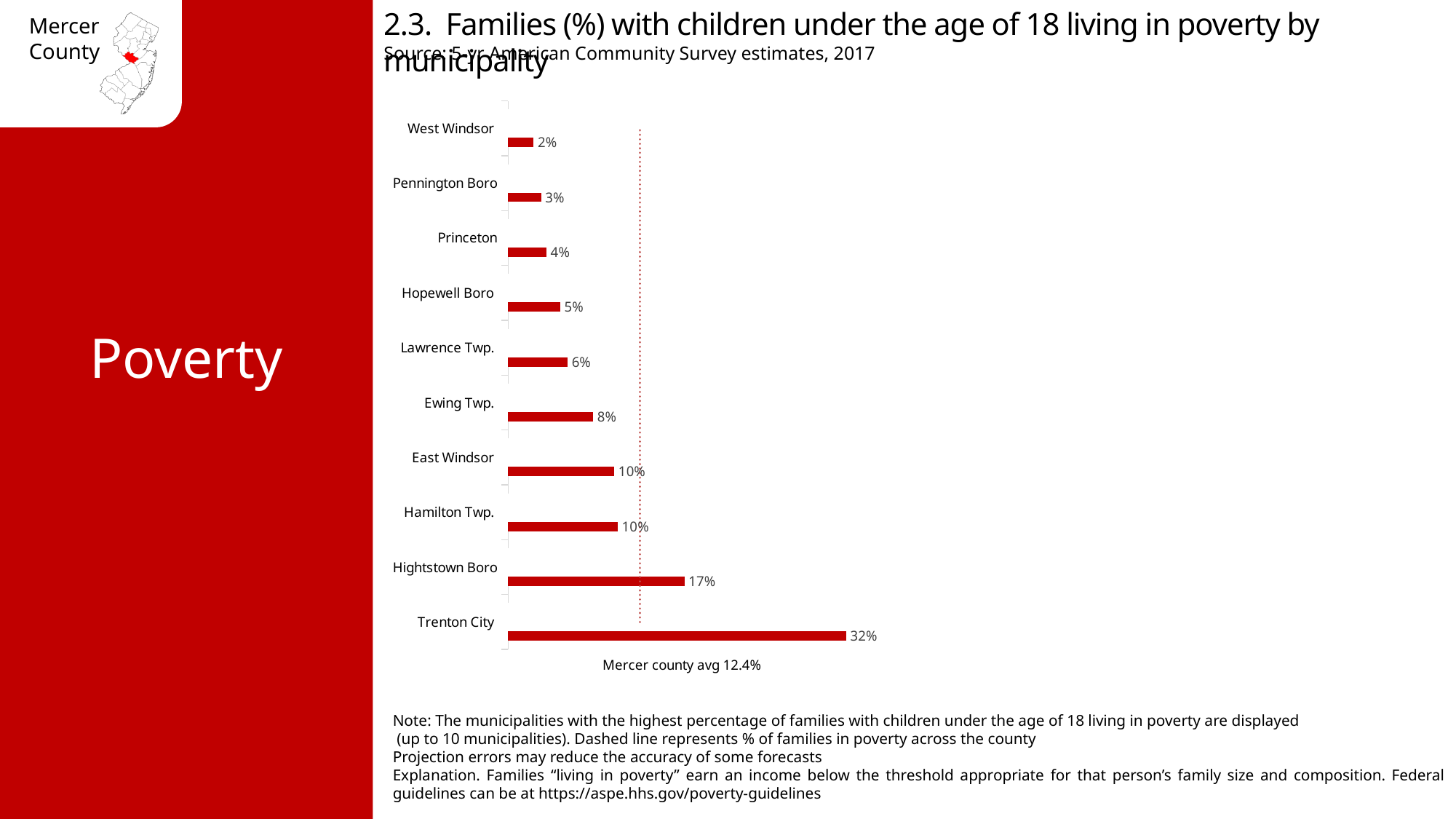
What is the value shown for Princeton? 4% How many municipalities are shown in the chart? 10 What percentage of families with children under 18 live in poverty in Trenton City? 32% What is the value shown for Hightstown Boro? 17% What is the Mercer county average shown by the dotted line? 12.4% What is the value shown for Lawrence Twp.? 6% Which has a higher value, Ewing Twp. or Hopewell Boro? Ewing Twp. What is the difference in percentage points between Trenton City and Hightstown Boro? 15 Which municipality has the highest percentage of families with children living in poverty? Trenton City Which municipality has the lowest percentage of families with children living in poverty? West Windsor What kind of chart is used on this slide? Bar chart What is the value shown for Pennington Boro? 3%